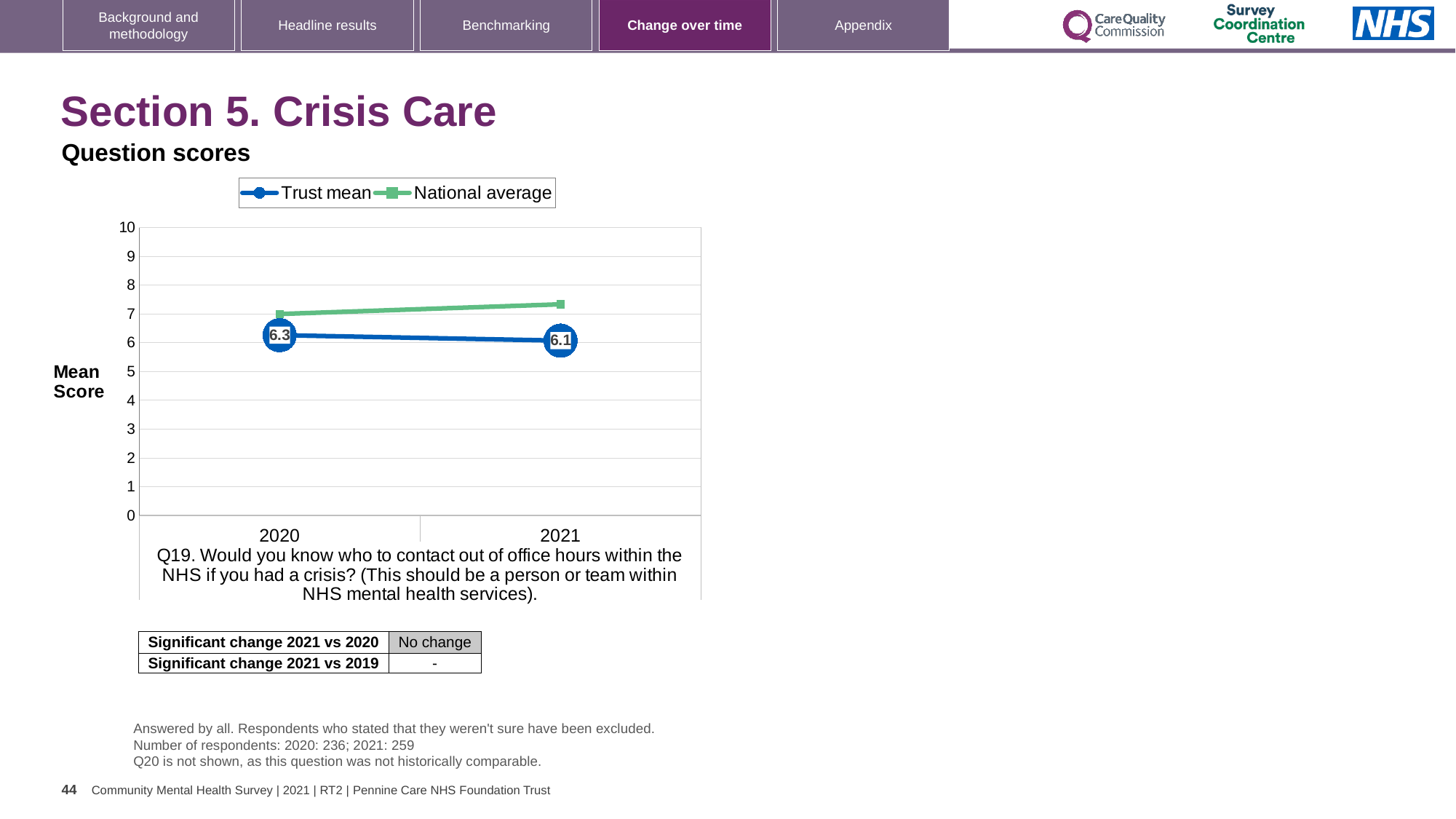
How many years are plotted on the x axis? 2 By how much did the Trust mean score change from 2020 to 2021? 0.2 Which year has the higher Trust mean score, 2020 or 2021? 2020 What is the label on the y axis of the chart? Mean Score What is the Trust mean score for 2020? 6.3 In 2021, which is higher: the Trust mean or the National average? National average Is the National average for 2021 greater or less than 8? less How many series does the legend list? 2 What kind of chart is shown on the slide? Line chart Does the Trust mean rise or fall from 2020 to 2021? Fall Is the National average for 2021 greater or less than 7? greater What is the Trust mean score for 2021? 6.1